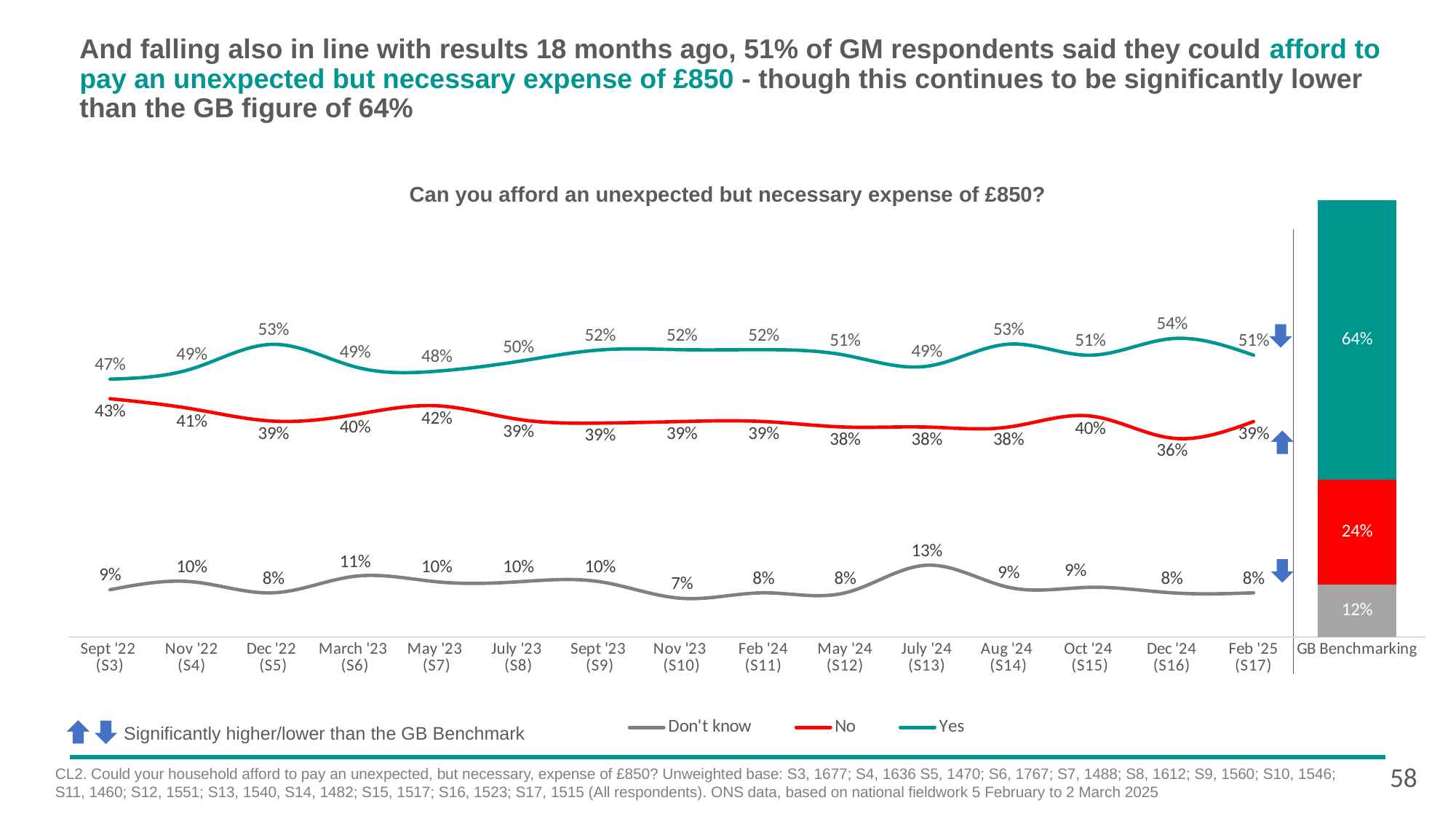
How many series does the legend list? 3 How many survey waves (time points) are plotted on the line chart, excluding the GB Benchmarking bar? 15 What is the 'No' value for Dec '24 (S16)? 36% In which survey wave is the 'Yes' value lowest? Sept '22 (S3) In which survey wave does the 'Yes' line reach its highest value? Dec '24 (S16) What is the difference between the GB Benchmarking 'Yes' value and the Feb '25 'Yes' value? 13% Which is larger: the 'No' value in Sept '22 or the 'No' value in Feb '25? Sept '22 What is the 'Yes' value shown for the GB Benchmarking bar? 64% In which survey wave is the 'Don't know' value highest? July '24 (S13) What percentage of respondents answered 'Yes' in Feb '25 (S17)? 51% What colour is the 'No' line in the chart? Red What is the total of the GB Benchmarking stacked bar? 100%